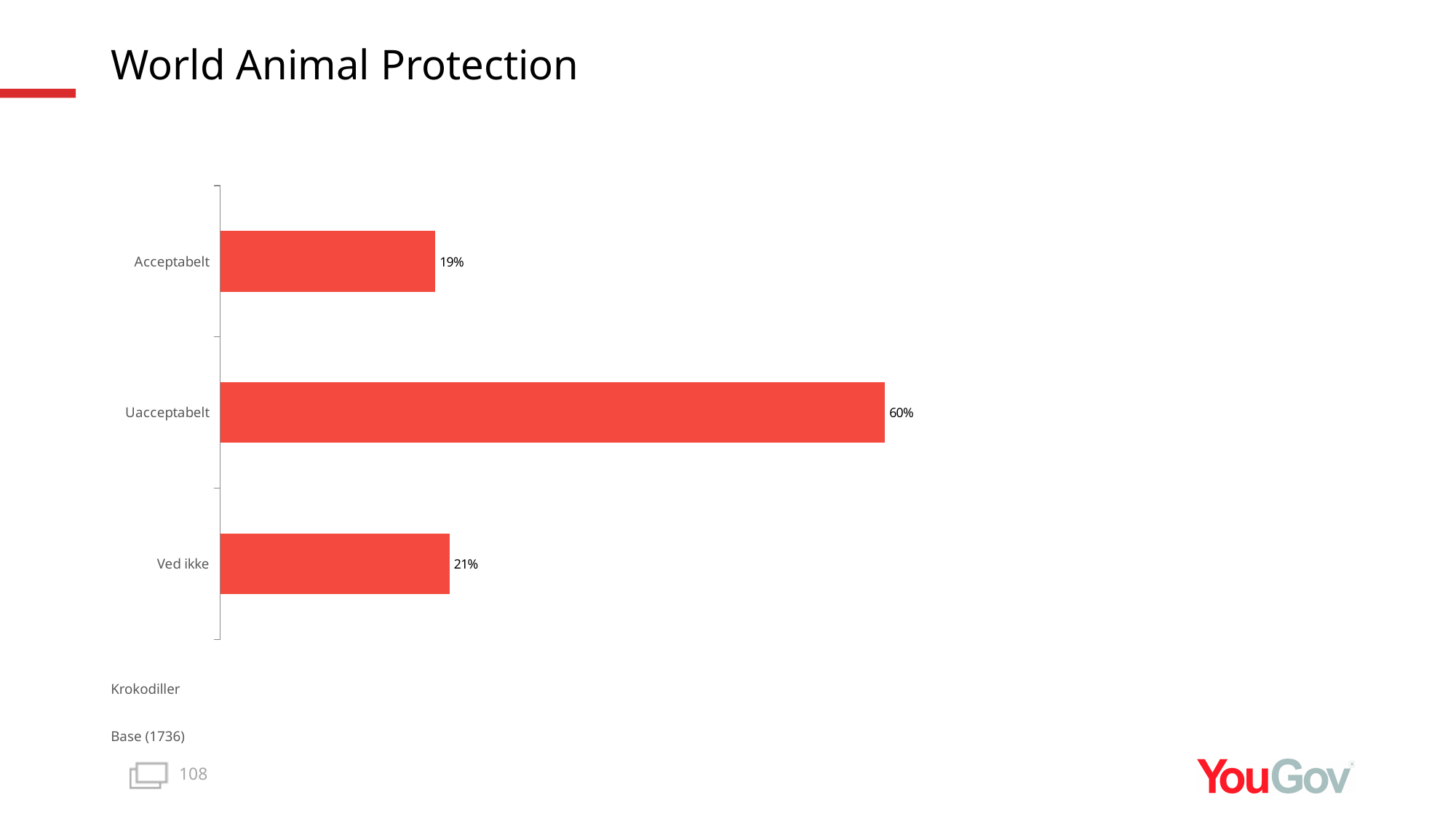
What is the difference between the values for Ved ikke and Acceptabelt? 2% What kind of chart is shown on the slide? Bar chart Which category has the highest value? Uacceptabelt What is the value for Acceptabelt? 19% How many categories are shown in the chart? 3 Which is larger, the value for Ved ikke or the value for Acceptabelt? Ved ikke What base size is stated below the chart? 1736 What is the difference between the values for Uacceptabelt and Acceptabelt? 41% What is the value for Uacceptabelt? 60% Which category has the lowest value? Acceptabelt What is the title of the slide? World Animal Protection What is the value for Ved ikke? 21%